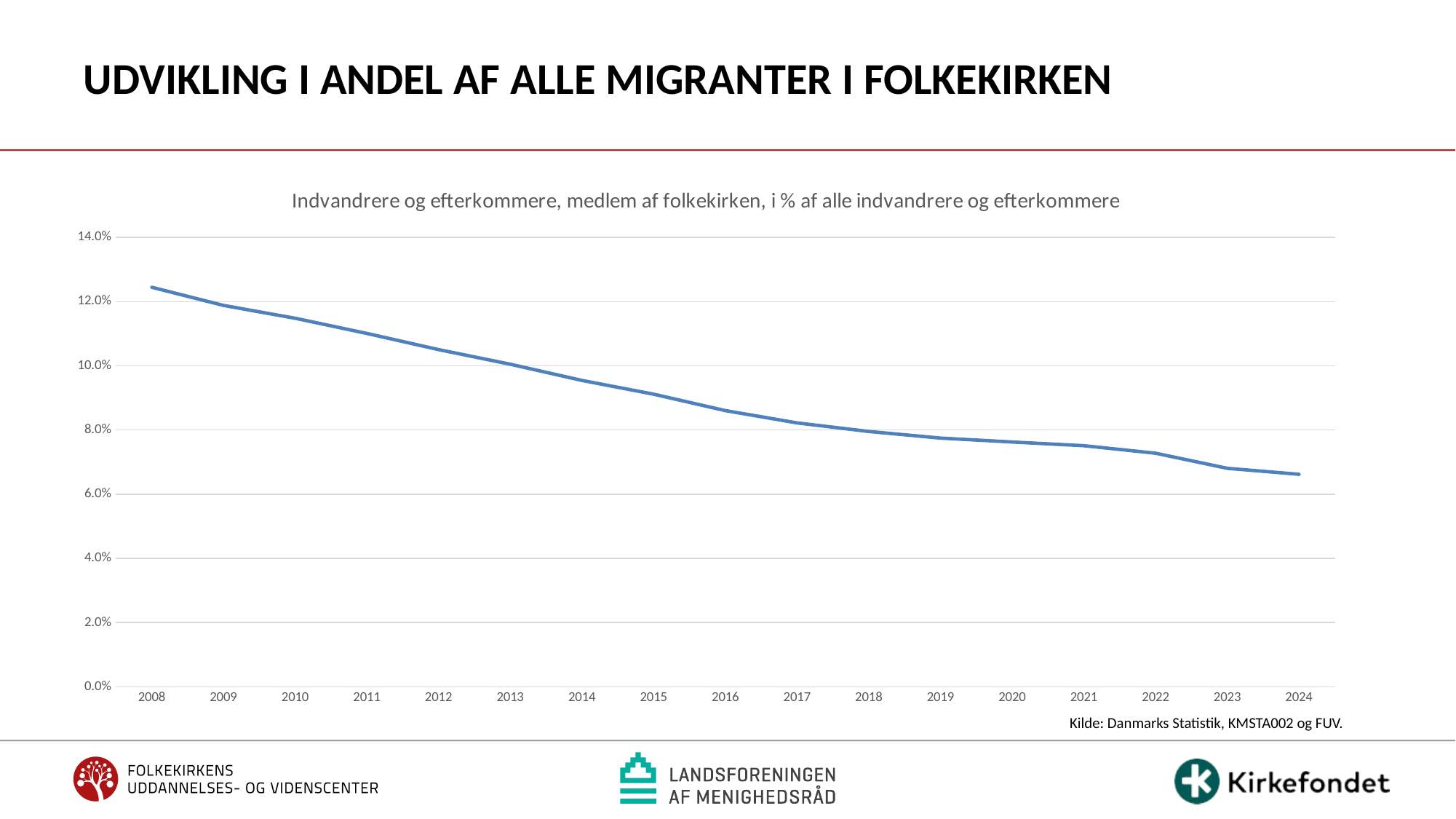
What is the title of the chart? Indvandrere og efterkommere, medlem af folkekirken, i % af alle indvandrere og efterkommere What is the highest value shown on the y axis? 14.0% Which year has the lowest value? 2024 Which is larger, the value for 2010 or the value for 2020? 2010 Is the value for 2018 greater or less than 10.0%? less How many years are plotted along the x axis? 17 Is the value for 2013 greater or less than 8.0%? greater Is the value for 2024 greater or less than 8.0%? less What kind of chart is shown on the slide? line chart Which year has the highest value? 2008 Do the values rise or fall from 2008 to 2024? fall